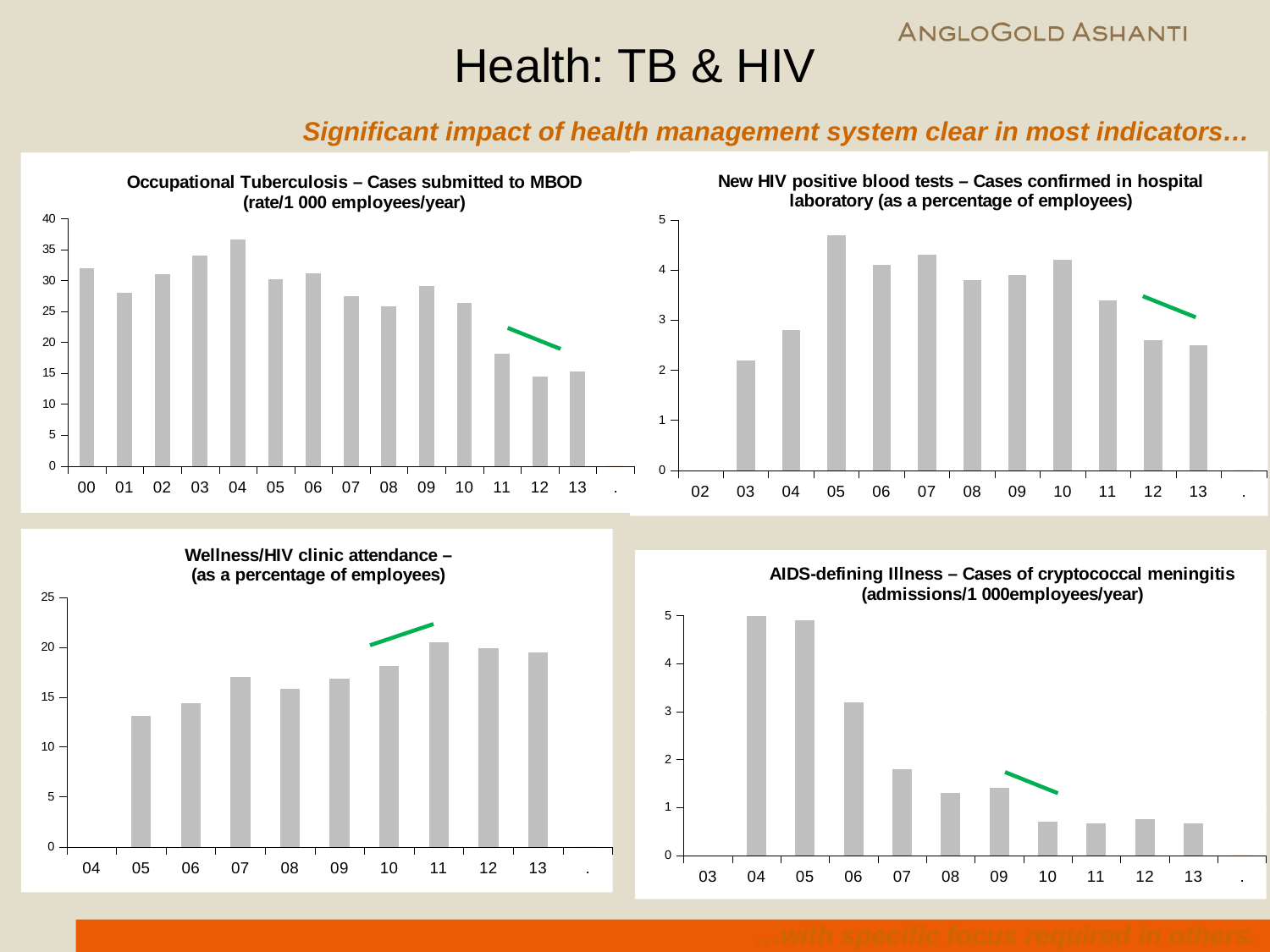
In the 'Occupational Tuberculosis' chart, is the value for 04 greater or less than 35? greater In the 'Occupational Tuberculosis' chart, which year has the highest value? 04 In the 'AIDS-defining Illness' chart, is the value for 10 greater or less than 1? less In the 'Occupational Tuberculosis' chart, do the values generally rise or fall from 09 to 12? fall In the 'Wellness/HIV clinic attendance' chart, which year has the highest value? 11 In the 'Occupational Tuberculosis' chart, which year has the lowest value? 12 In the 'Wellness/HIV clinic attendance' chart, is the value for 05 greater or less than 15? less In the 'New HIV positive blood tests' chart, which year has the lowest value? 03 In the 'New HIV positive blood tests' chart, which year has the highest value? 05 What type of chart is the 'Occupational Tuberculosis' chart at the top left? bar chart In the 'Occupational Tuberculosis' chart, how many years are shown on the x axis? 14